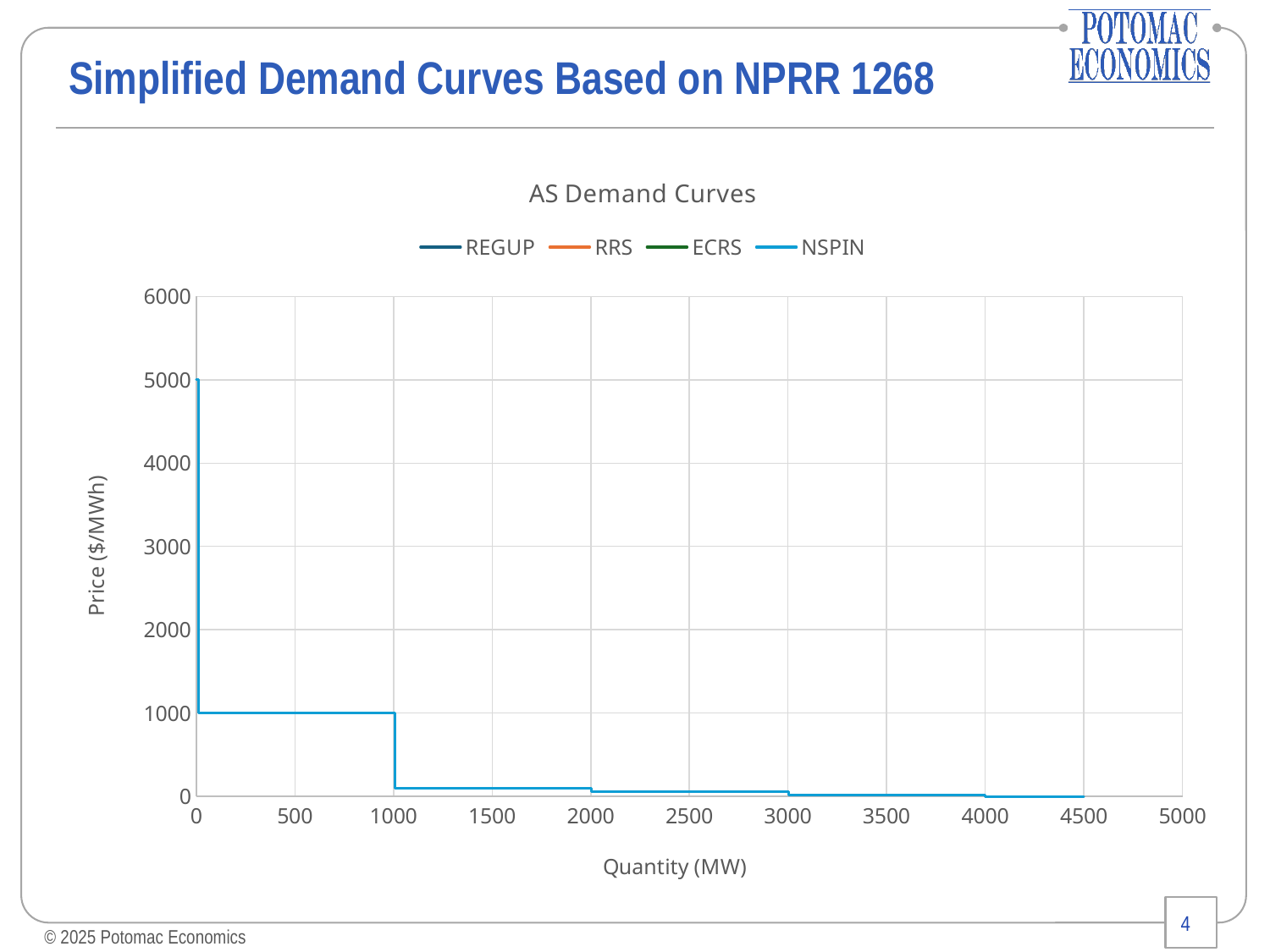
Is the price on the demand curves at a quantity of 0 MW greater or less than 4000? greater Do the demand curve prices rise or fall as quantity increases along the x axis? fall Which is larger: the price on the demand curves at 500 MW or at 2500 MW? 500 MW At which quantity (MW) do the demand curves reach their highest price? 0 What is the price ($/MWh) on the demand curves at a quantity of 500 MW? 1000 Is the price on the demand curves at a quantity of 1500 MW greater or less than 500? less What is the highest price ($/MWh) reached by the demand curves, at a quantity of 0 MW? 5000 Is the price on the demand curves at a quantity of 800 MW greater or less than 2000? less How many series does the legend of the AS Demand Curves chart list? 4 What is the label of the x axis of the chart? Quantity (MW) What kind of chart is shown on the slide? line chart What is the title of the chart? AS Demand Curves